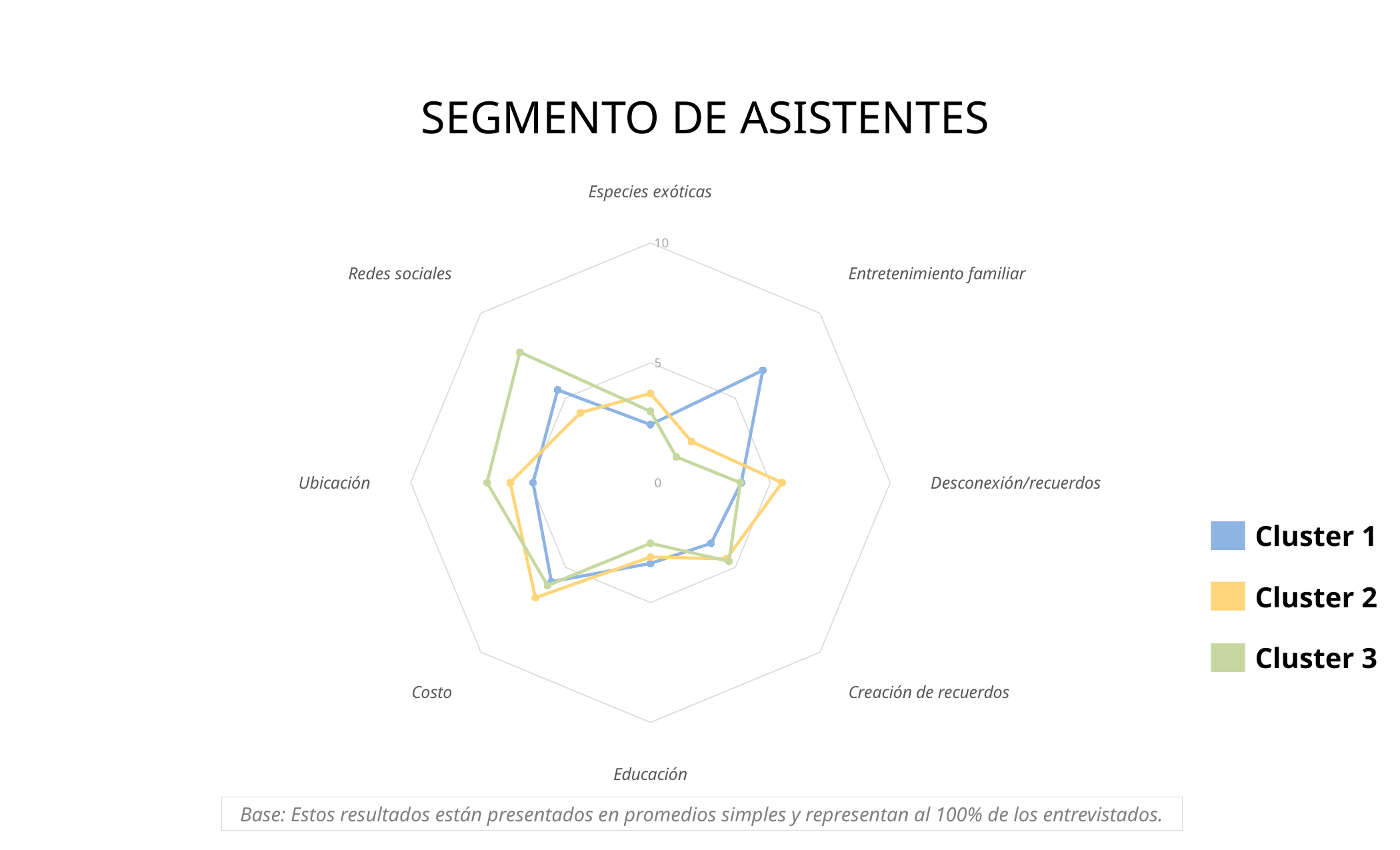
What colour represents Cluster 2 in the legend? Yellow How many categories (axes) does the radar chart have? 8 Is the value for Cluster 1 on Entretenimiento familiar greater or less than 5? greater Is the value for Cluster 2 on Especies exóticas greater or less than 5? less Is the value for Cluster 2 on Costo greater or less than 5? greater On which category does Cluster 3 have its highest value? Redes sociales What kind of chart is shown on the slide? Radar chart On Entretenimiento familiar, which is larger: Cluster 1 or Cluster 3? Cluster 1 On which category does Cluster 3 have its lowest value? Entretenimiento familiar How many series does the legend list? 3